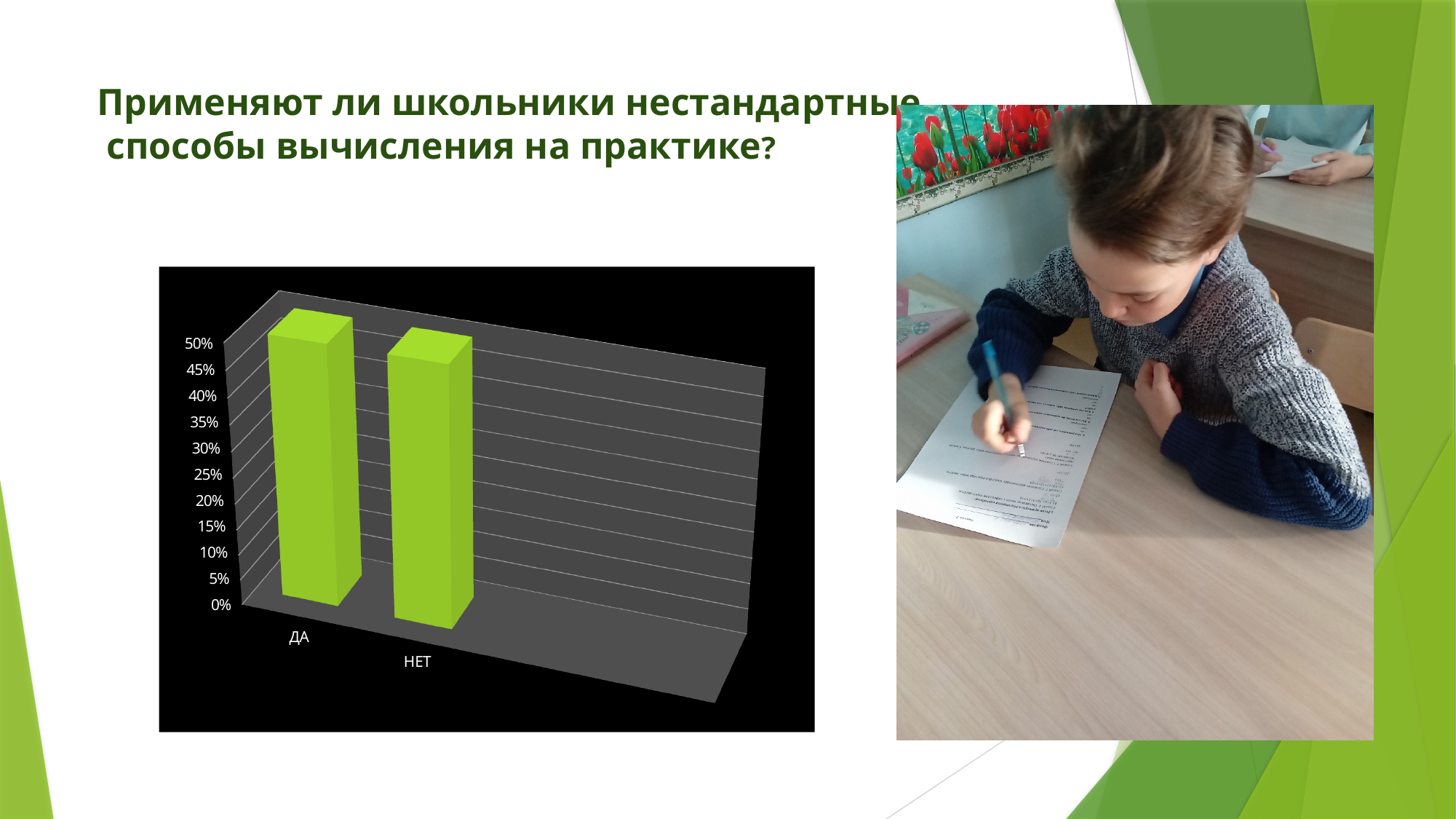
What are the two category labels on the chart's x axis? ДА and НЕТ What kind of chart is shown on the slide? bar chart What is the highest tick label shown on the chart's vertical axis? 50% Is the value for НЕТ greater or less than 25%? greater Is the value for ДА greater or less than 20%? greater Is the value for ДА greater or less than 25%? greater How many categories are shown on the chart's x axis? 2